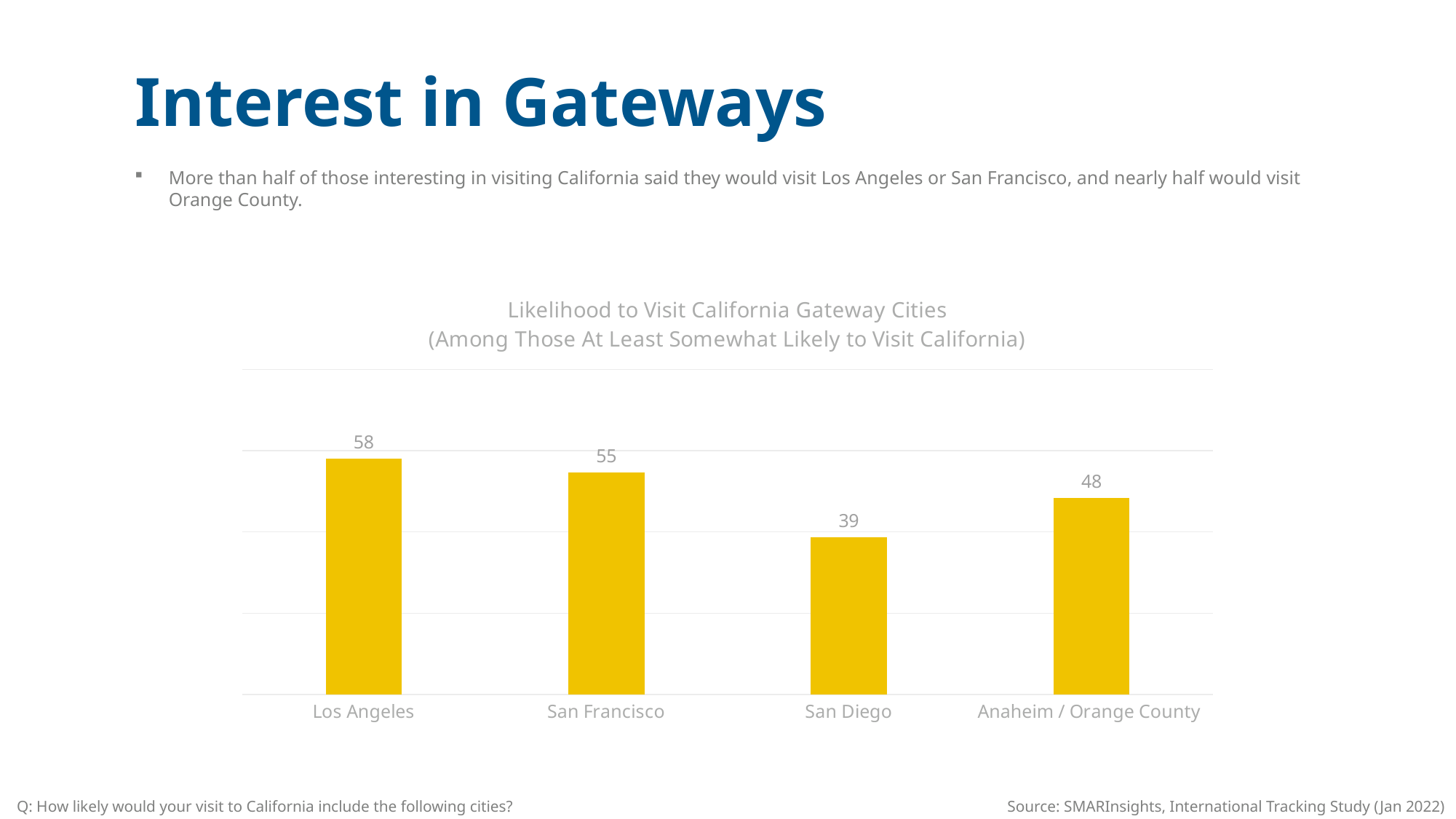
What is the value for San Francisco? 55 How many cities are shown in the chart? 4 What is the title of the chart? Likelihood to Visit California Gateway Cities (Among Those At Least Somewhat Likely to Visit California) What is the difference between the values for Los Angeles and San Diego? 19 What kind of chart is shown on the slide? Bar chart Which city has the lowest value? San Diego What is the difference between the values for San Francisco and Anaheim / Orange County? 7 Which has a larger value, San Diego or Anaheim / Orange County? Anaheim / Orange County What is the value for San Diego? 39 Which city has the highest value? Los Angeles What is the value for Los Angeles? 58 What is the value for Anaheim / Orange County? 48